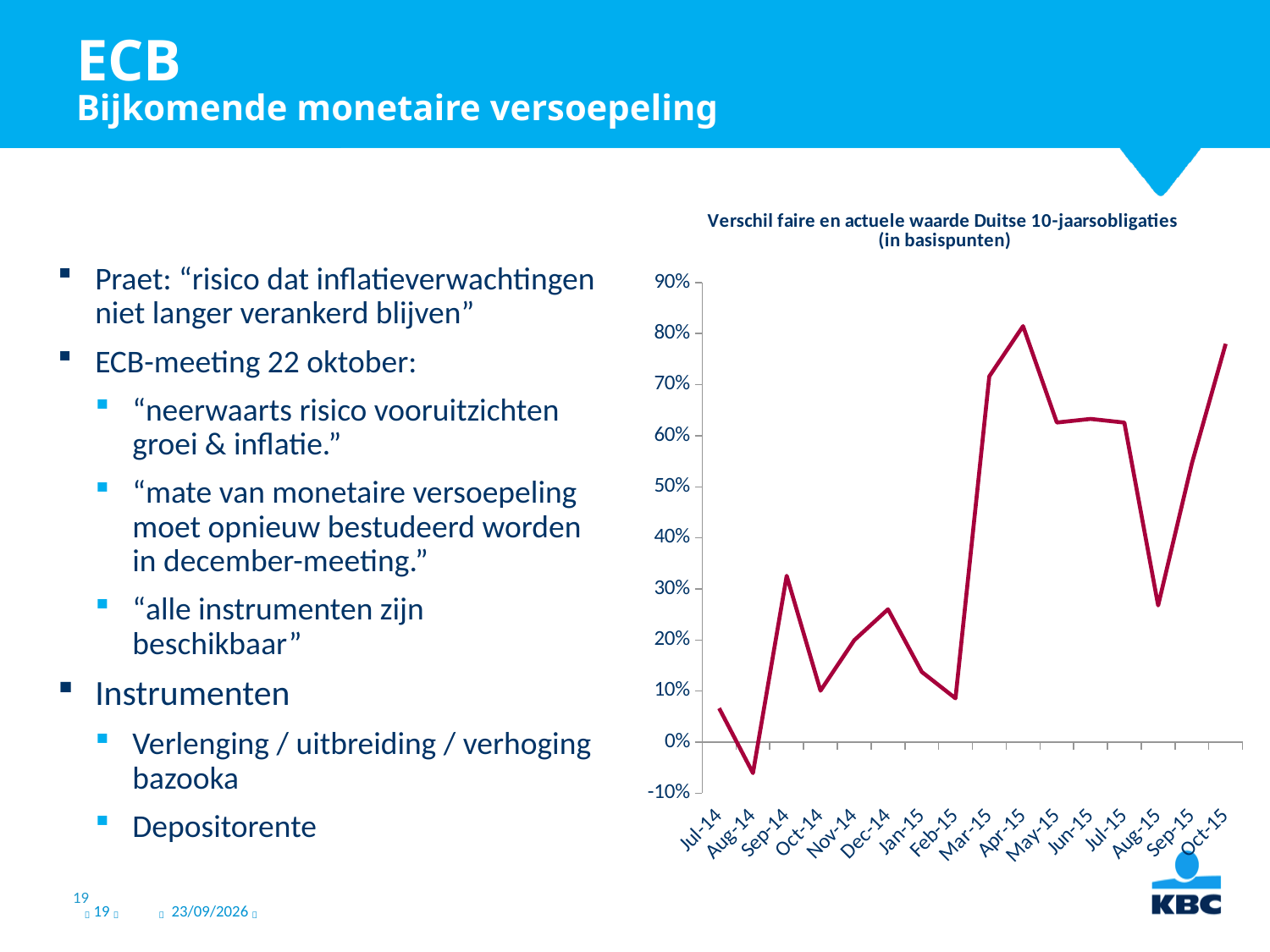
Is the value for Apr-15 greater or less than 70%? greater Is the value for Oct-15 greater or less than 70%? greater Which is larger, the value for Apr-15 or the value for Aug-15? Apr-15 Is the value for Aug-15 greater or less than 40%? less How many months are shown on the x axis of the chart? 16 Which is larger, the value for Sep-14 or the value for Oct-14? Sep-14 Which month has the lowest value in the chart? Aug-14 What is the title of the chart? Verschil faire en actuele waarde Duitse 10-jaarsobligaties (in basispunten) What kind of chart is shown on the slide? line chart Does the line rise or fall from Feb-15 to Apr-15? rise